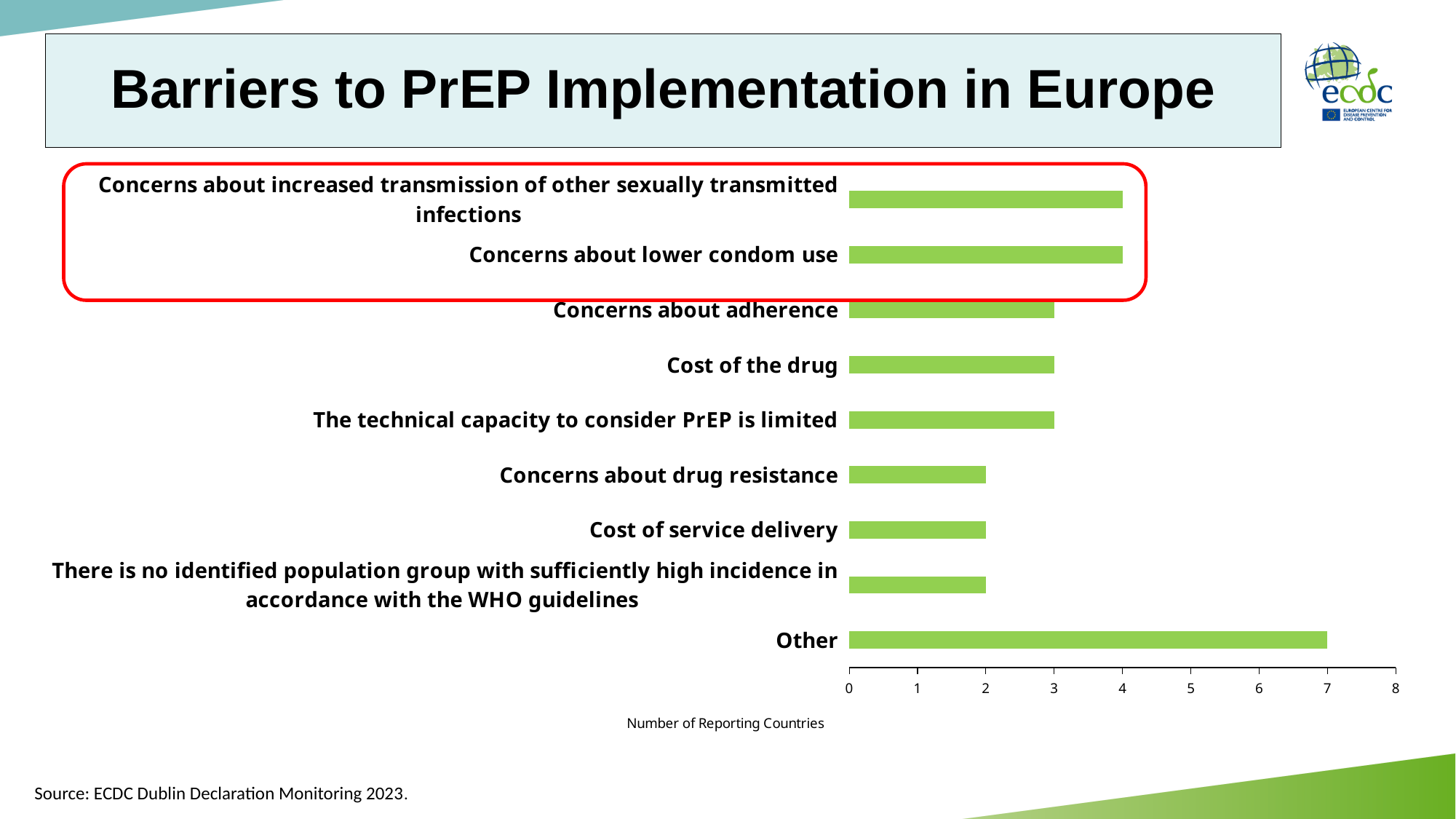
How many barriers (categories) are plotted in the chart? 9 Which has more reporting countries: 'Concerns about increased transmission of other sexually transmitted infections' or 'Cost of service delivery'? Concerns about increased transmission of other sexually transmitted infections What is the difference in reporting countries between 'Other' and 'Concerns about adherence'? 4 Is the value for 'Other' greater or less than 5? greater What is the number of reporting countries for 'Concerns about lower condom use'? 4 What is the number of reporting countries for 'Concerns about drug resistance'? 2 What is the number of reporting countries for 'Other'? 7 Which barrier has the highest number of reporting countries? Other What is the number of reporting countries for 'Cost of the drug'? 3 What is the title of the slide containing the chart? Barriers to PrEP Implementation in Europe What kind of chart is shown on the slide? bar chart What is the label of the horizontal axis? Number of Reporting Countries